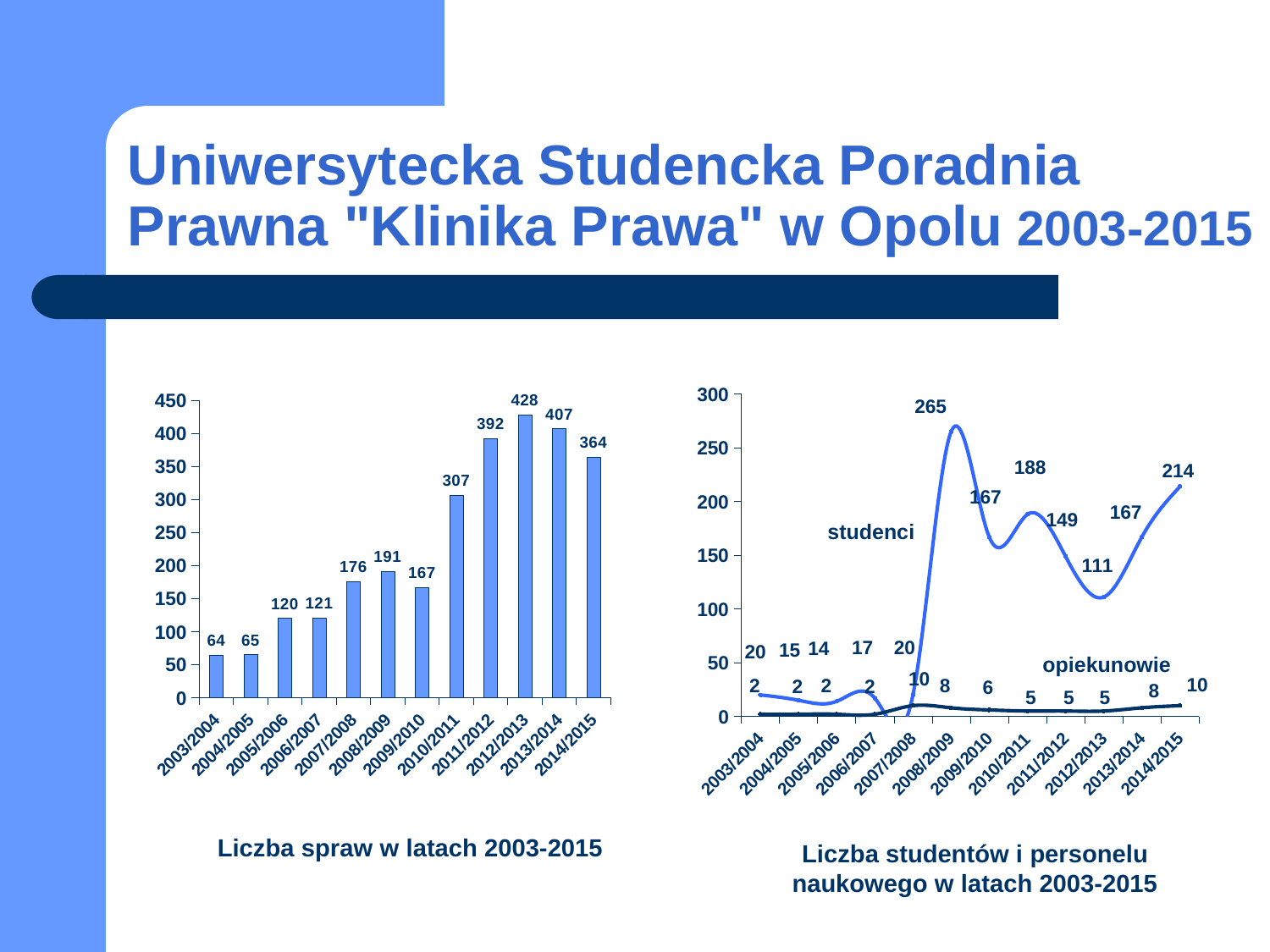
In the right chart (Liczba studentów i personelu naukowego), what is the difference between the studenci values for 2014/2015 and 2013/2014? 47 In the left chart (Liczba spraw w latach 2003-2015), which year has the lowest value? 2003/2004 In the left chart (Liczba spraw w latach 2003-2015), how many years are shown on the x axis? 12 In the right chart (Liczba studentów i personelu naukowego), what is the value for studenci in 2008/2009? 265 In the left chart (Liczba spraw w latach 2003-2015), what is the difference between the values for 2012/2013 and 2014/2015? 64 In the left chart (Liczba spraw w latach 2003-2015), which year has the highest value? 2012/2013 In the right chart (Liczba studentów i personelu naukowego), which is larger in 2011/2012: studenci or opiekunowie? studenci What kind of chart is the right chart (Liczba studentów i personelu naukowego)? line chart What kind of chart is the left chart (Liczba spraw w latach 2003-2015)? bar chart In the left chart (Liczba spraw w latach 2003-2015), what is the value for 2010/2011? 307 In the right chart (Liczba studentów i personelu naukowego), in which year does the studenci series reach its highest value? 2008/2009 In the right chart (Liczba studentów i personelu naukowego), what is the value for opiekunowie in 2014/2015? 10